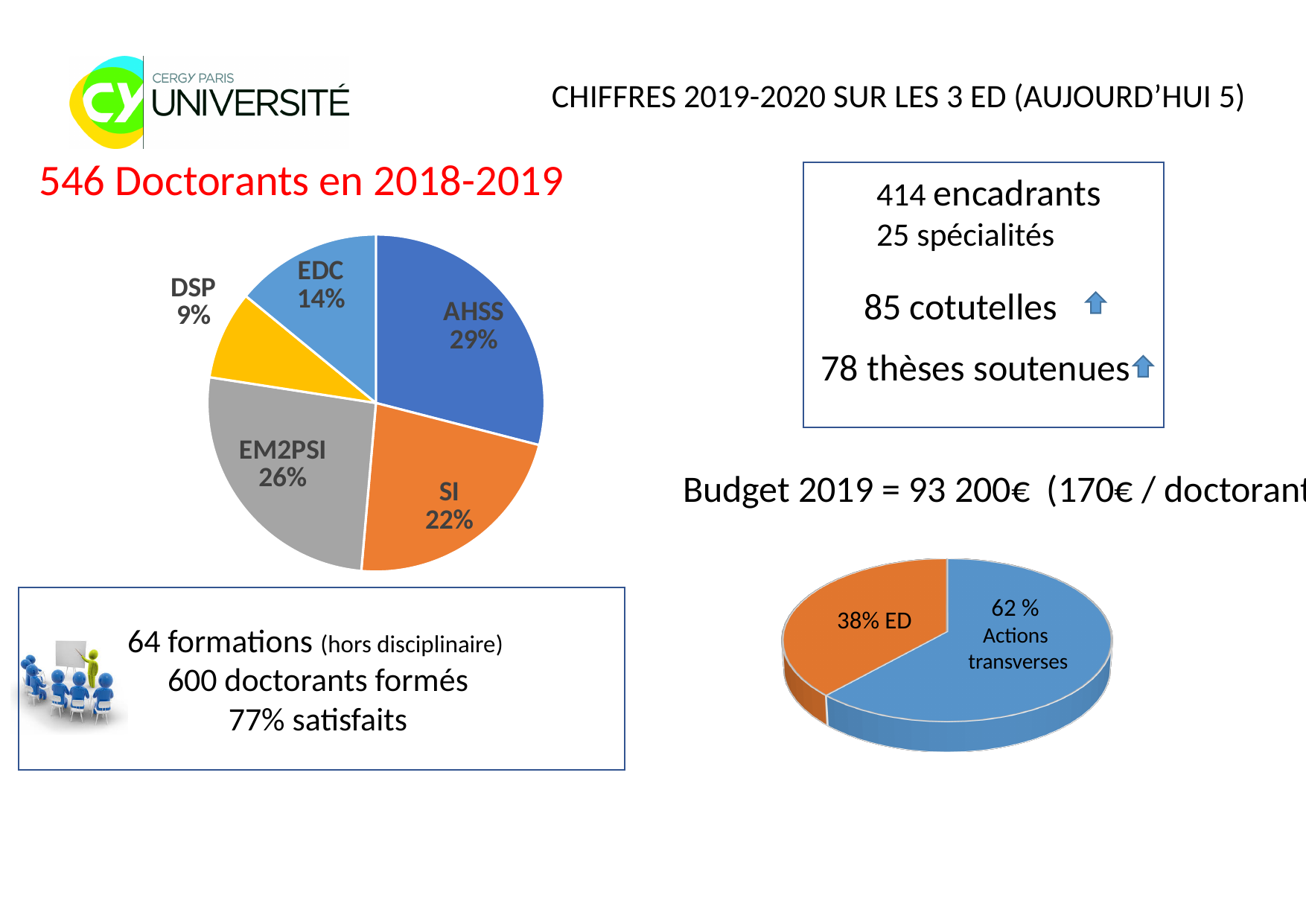
In the pie chart on the left of the slide, what is the difference in percentage points between AHSS and SI? 7 In the pie chart on the left of the slide, which is larger, EDC or SI? SI In the pie chart on the left of the slide, what share is shown for DSP? 9% In the pie chart on the left of the slide, what share is shown for AHSS? 29% In the pie chart on the left of the slide, which category has the smallest share? DSP In the pie chart at the bottom right of the slide, what share is shown for Actions transverses? 62 % In the pie chart on the left of the slide, what share is shown for EM2PSI? 26% In the pie chart at the bottom right of the slide, what share is shown for ED? 38% What kind of chart is shown at the bottom right of the slide? Pie chart In the pie chart on the left of the slide, which category has the largest share? AHSS In the pie chart on the left of the slide, how many categories are shown? 5 In the pie chart at the bottom right of the slide, which slice is larger, ED or Actions transverses? Actions transverses